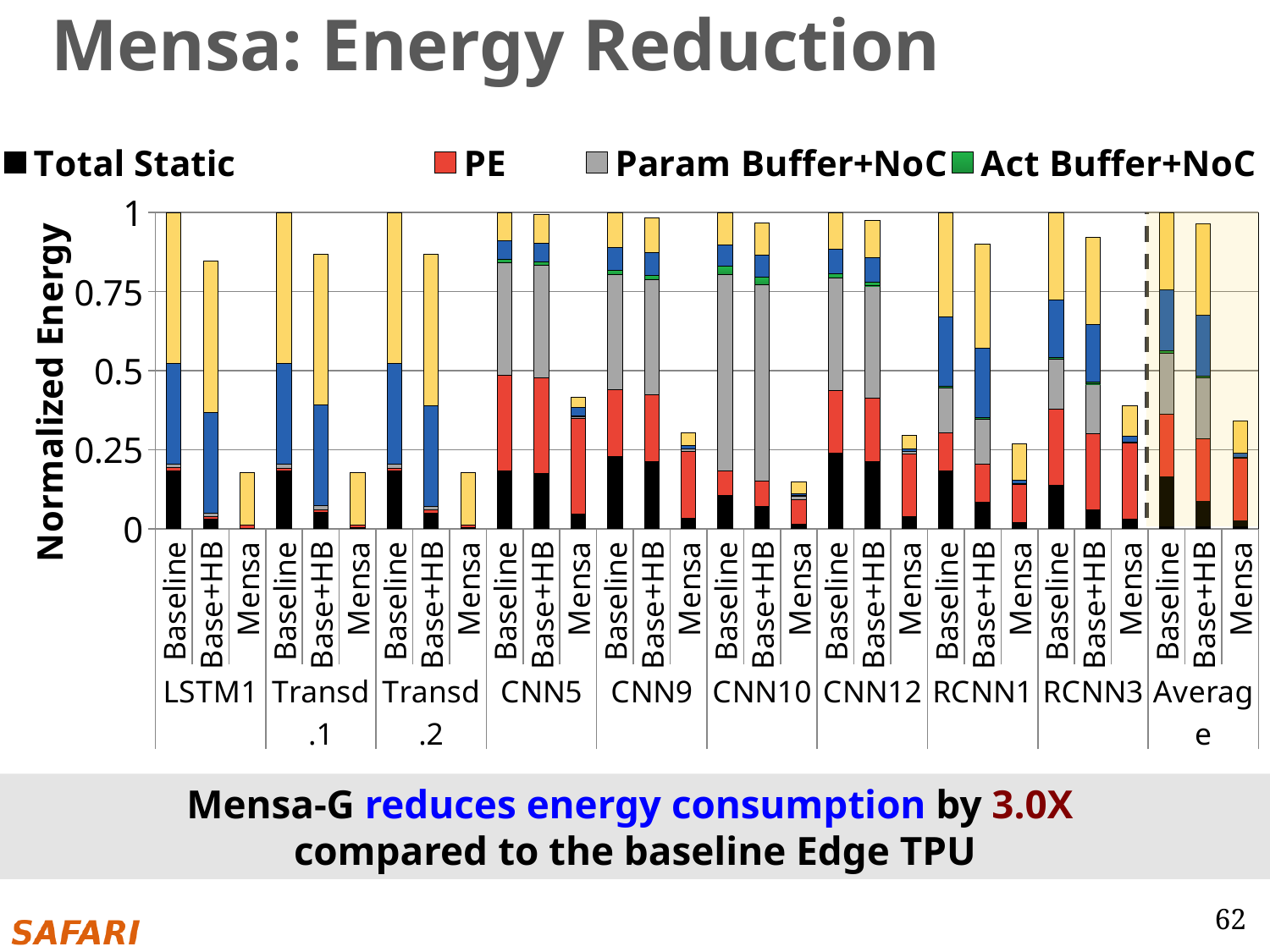
For RCNN1, which bar is taller: Baseline or Mensa? Baseline Is the total value of the Mensa bar for CNN5 greater or less than 0.25? greater What kind of chart is shown on the slide? stacked bar chart Is the total value of the Mensa bar for CNN10 greater or less than 0.25? less What is the label of the vertical axis? Normalized Energy Is the total value of the Mensa bar in the Average group greater or less than 0.5? less What is the total normalized energy of the Baseline bar for LSTM1? 1 How many workload groups are shown along the x axis, including Average? 10 How many bars are plotted in total across all groups? 30 In the Average group, which configuration has the lowest total normalized energy? Mensa